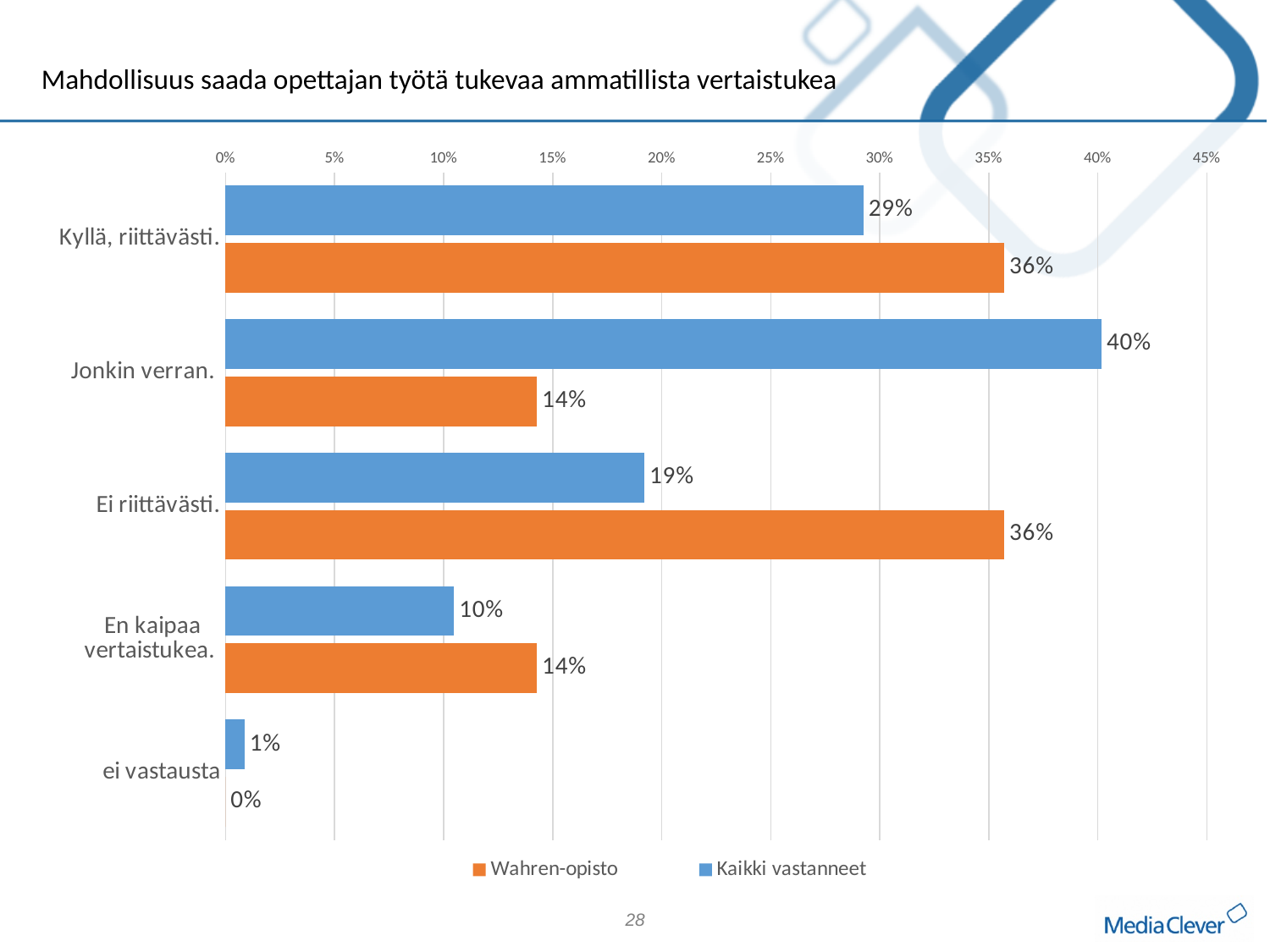
In the category "Ei riittävästi.", which series has the larger value, Wahren-opisto or Kaikki vastanneet? Wahren-opisto What is the value for Kaikki vastanneet in the category "En kaipaa vertaistukea."? 10% How many categories are shown on the chart? 5 Which category has the highest value for Kaikki vastanneet? Jonkin verran. What is the title of the chart? Mahdollisuus saada opettajan työtä tukevaa ammatillista vertaistukea How many series does the legend list? 2 What is the difference between Kaikki vastanneet and Wahren-opisto in the category "Jonkin verran."? 26% What kind of chart is shown on the slide? bar chart Which category has the lowest value for Wahren-opisto? ei vastausta What is the value for Wahren-opisto in the category "Ei riittävästi."? 36% What is the value for Kaikki vastanneet in the category "Jonkin verran."? 40% What is the value for Wahren-opisto in the category "Kyllä, riittävästi."? 36%